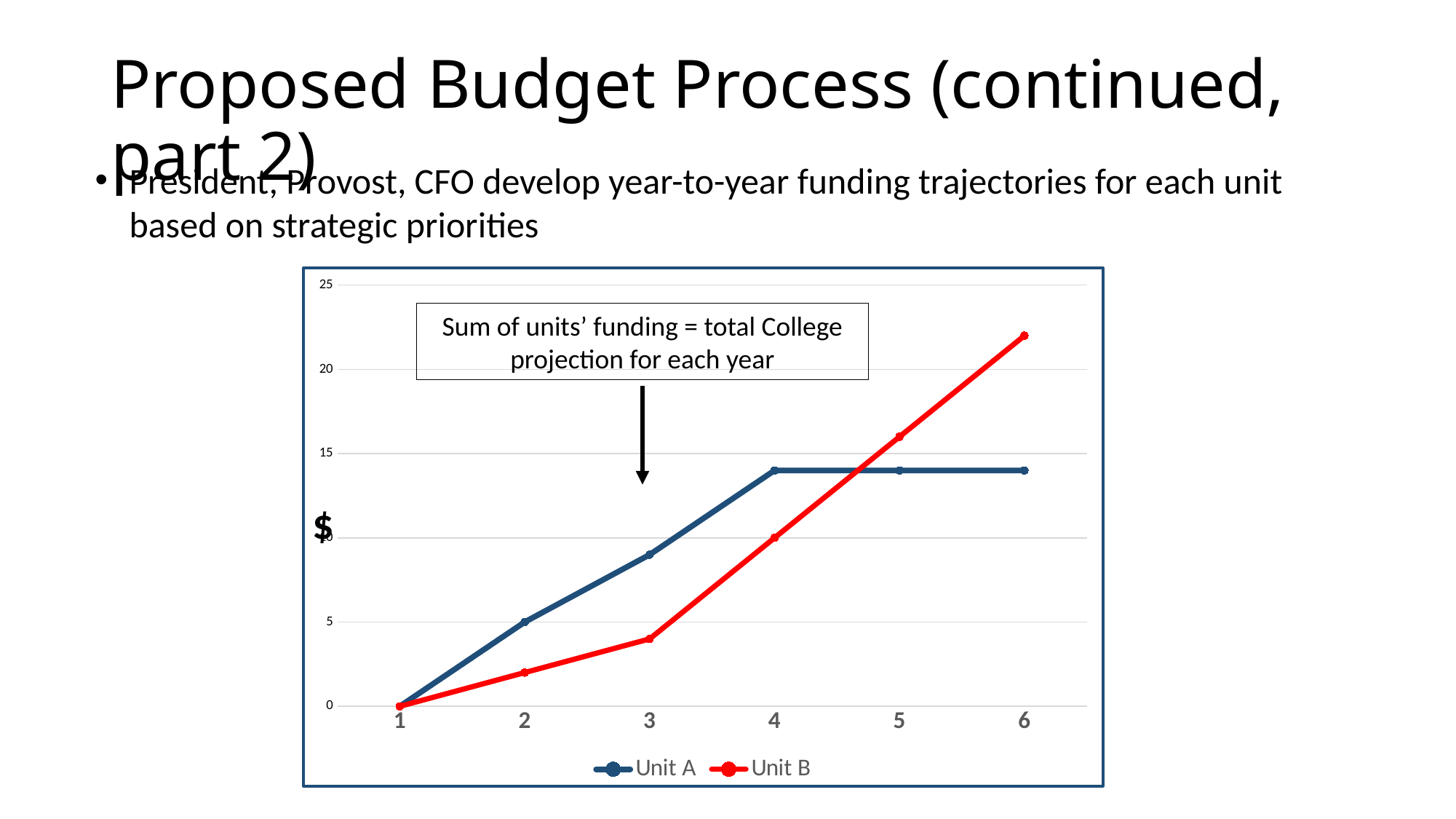
Do the values for Unit B rise or fall from year 1 to year 6? rise Is the value for Unit B at year 3 greater or less than 5? less Which colour is used for the Unit B line? red What is the value for Unit A at year 1? 0 Is the value for Unit B at year 6 greater or less than 20? greater Is the value for Unit A at year 4 greater or less than 15? less At year 3, which series has the larger value, Unit A or Unit B? Unit A At year 6, which series has the larger value, Unit A or Unit B? Unit B How many points are plotted along the x axis for each series? 6 What is the value for Unit A at year 2? 5 How many series does the chart legend list? 2 What kind of chart is shown on the slide? line chart